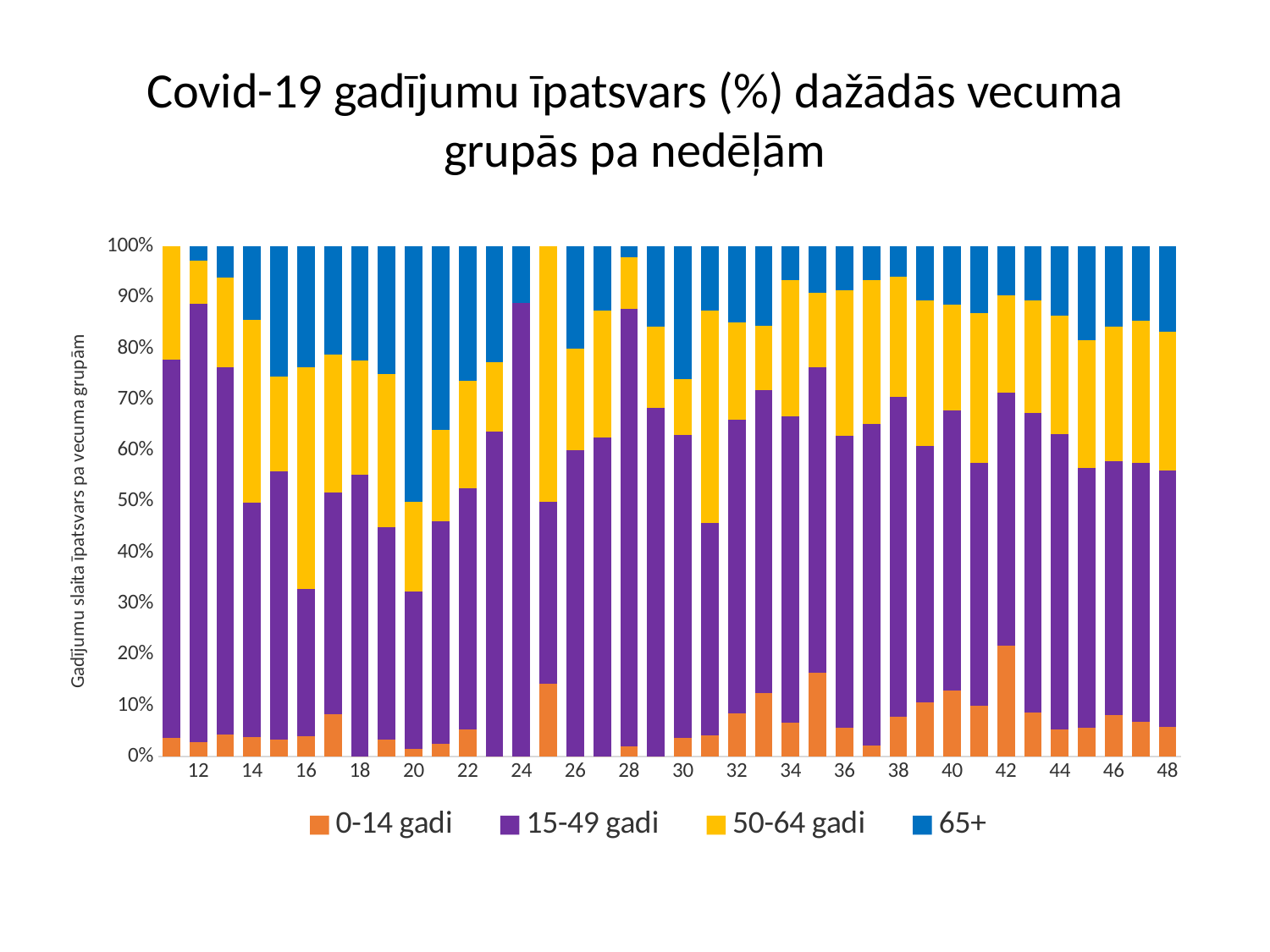
Which week has a larger share of the 0-14 gadi group, week 42 or week 29? Week 42 Is the share of the 0-14 gadi group in week 42 greater or less than 10%? greater Is the share of the 0-14 gadi group in week 35 greater or less than 10%? greater Which week has a larger share of the 65+ group, week 20 or week 12? Week 20 In which week is the share of the 65+ group the largest? 20 Which age group is shown in orange in the legend? 0-14 gadi In which week is the share of the 0-14 gadi group the largest? 42 Is the share of the 15-49 gadi group in week 24 greater or less than 80%? greater What kind of chart is shown on the slide? Stacked bar chart What is the title of the chart? Covid-19 gadījumu īpatsvars (%) dažādās vecuma grupās pa nedēļām How many weeks (bars) are plotted on the chart? 38 How many series does the legend list? 4